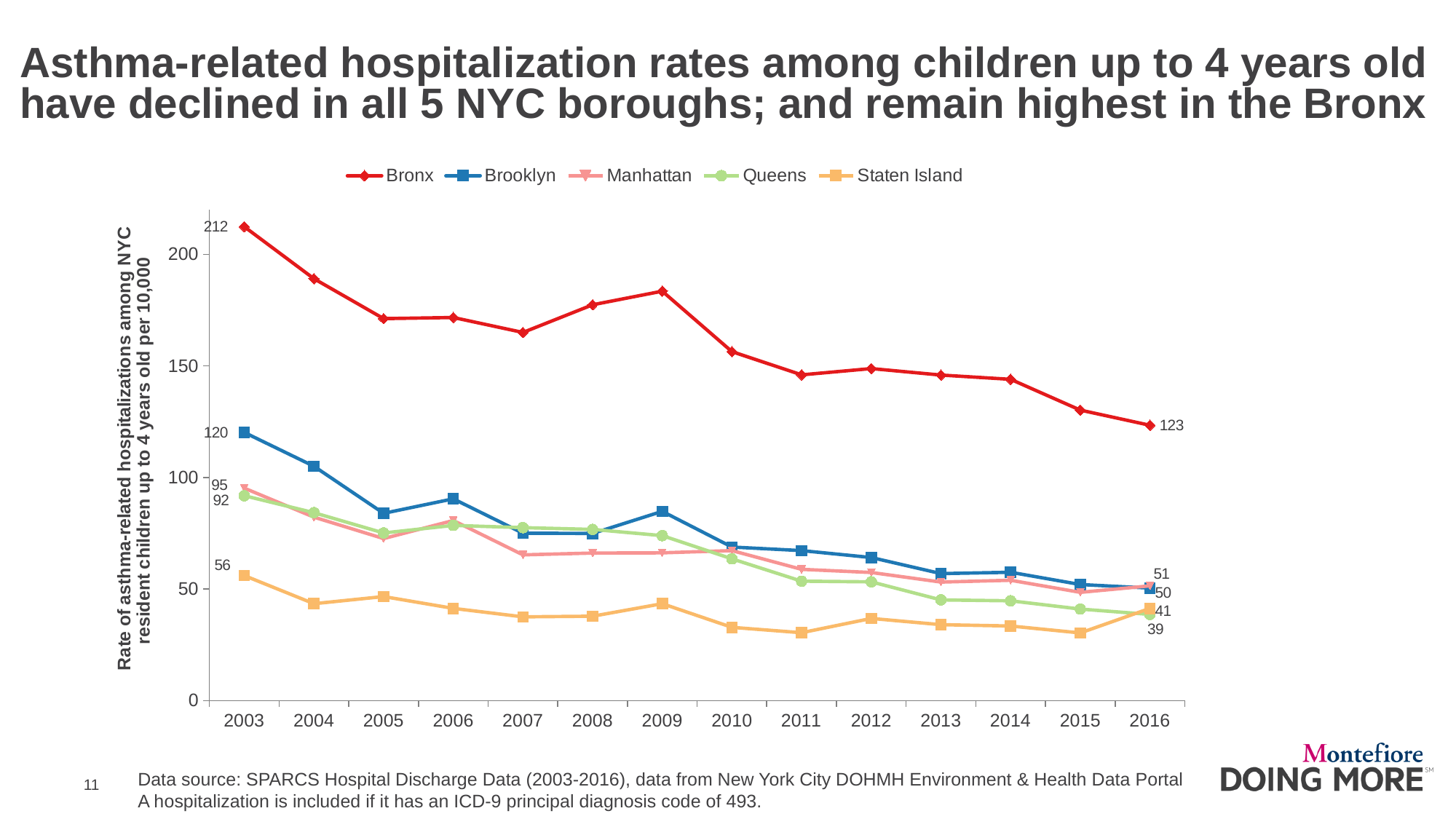
What was the Bronx rate in 2016? 123 Does the Bronx rate generally rise or fall from 2003 to 2016? Fall What was the Staten Island rate in 2003? 56 How many boroughs (series) does the legend list? 5 What was the Manhattan rate in 2003? 95 Which borough had the highest rate in 2003? Bronx What was the Brooklyn rate in 2003? 120 Is the Bronx value for 2010 greater or less than 150? greater What was the Bronx asthma-related hospitalization rate in 2003? 212 By how much did the Bronx rate fall from 2003 to 2016? 89 Which borough had the lowest rate in 2003? Staten Island What kind of chart is shown on the slide? Line chart